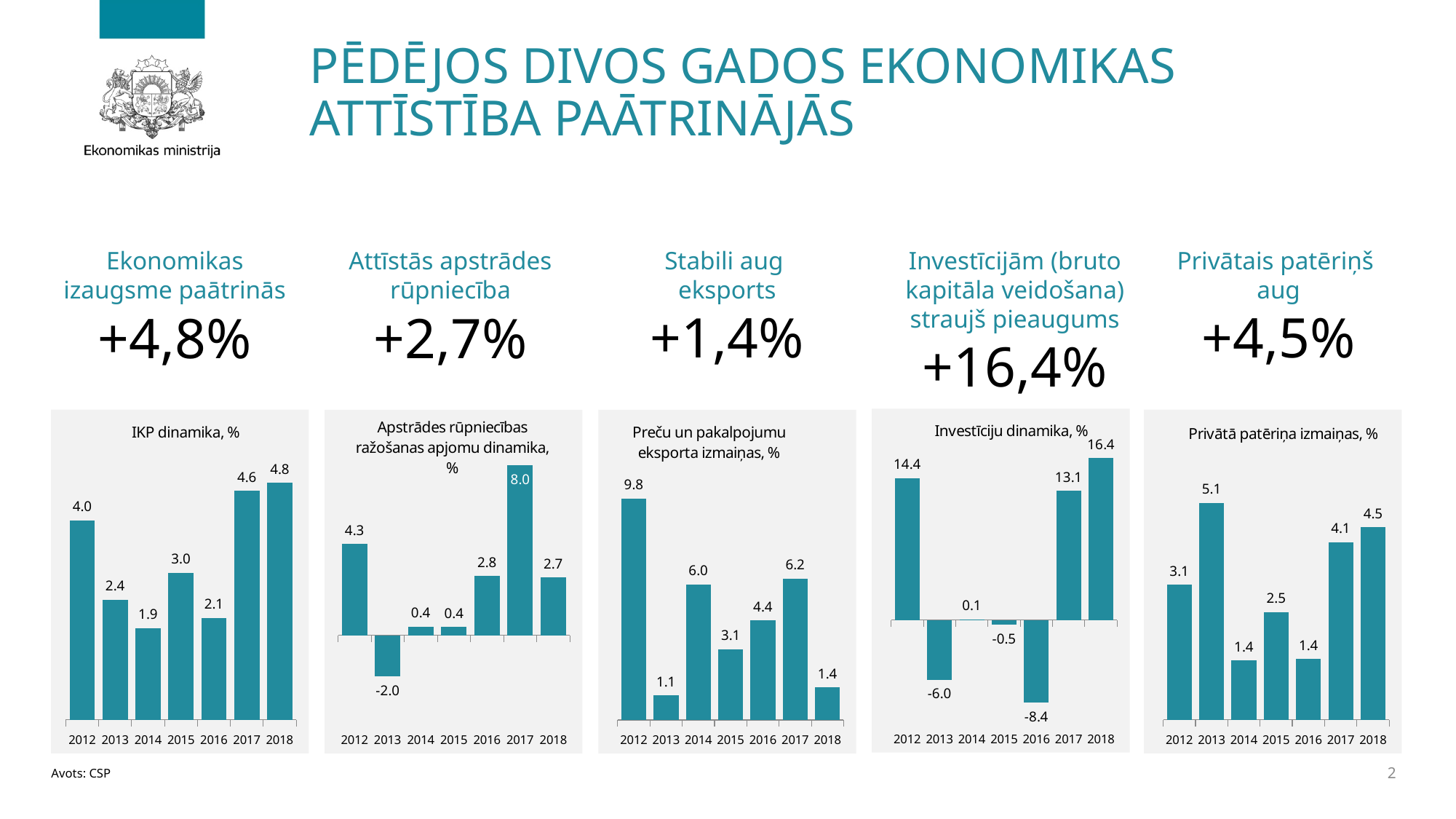
In the 'Preču un pakalpojumu eksporta izmaiņas, %' chart, which is larger, the value for 2014 or the value for 2017? 2017 In the 'IKP dinamika, %' chart, what is the value for 2015? 3.0 In the 'Privātā patēriņa izmaiņas, %' chart, what is the difference between the values for 2018 and 2017? 0.4 In the 'Apstrādes rūpniecības ražošanas apjomu dinamika, %' chart, what is the value for 2013? -2.0 In the 'Preču un pakalpojumu eksporta izmaiņas, %' chart, what is the difference between the values for 2012 and 2013? 8.7 In the 'Investīciju dinamika, %' chart, which year has the highest value? 2018 What type of chart is the 'Investīciju dinamika, %' chart? Bar chart In the 'Apstrādes rūpniecības ražošanas apjomu dinamika, %' chart, which year has the highest value? 2017 In the 'Privātā patēriņa izmaiņas, %' chart, what is the value for 2013? 5.1 How many years are shown on the x axis of the 'IKP dinamika, %' chart? 7 In the 'Investīciju dinamika, %' chart, what is the value for 2016? -8.4 In the 'IKP dinamika, %' chart, which year has the lowest value? 2014